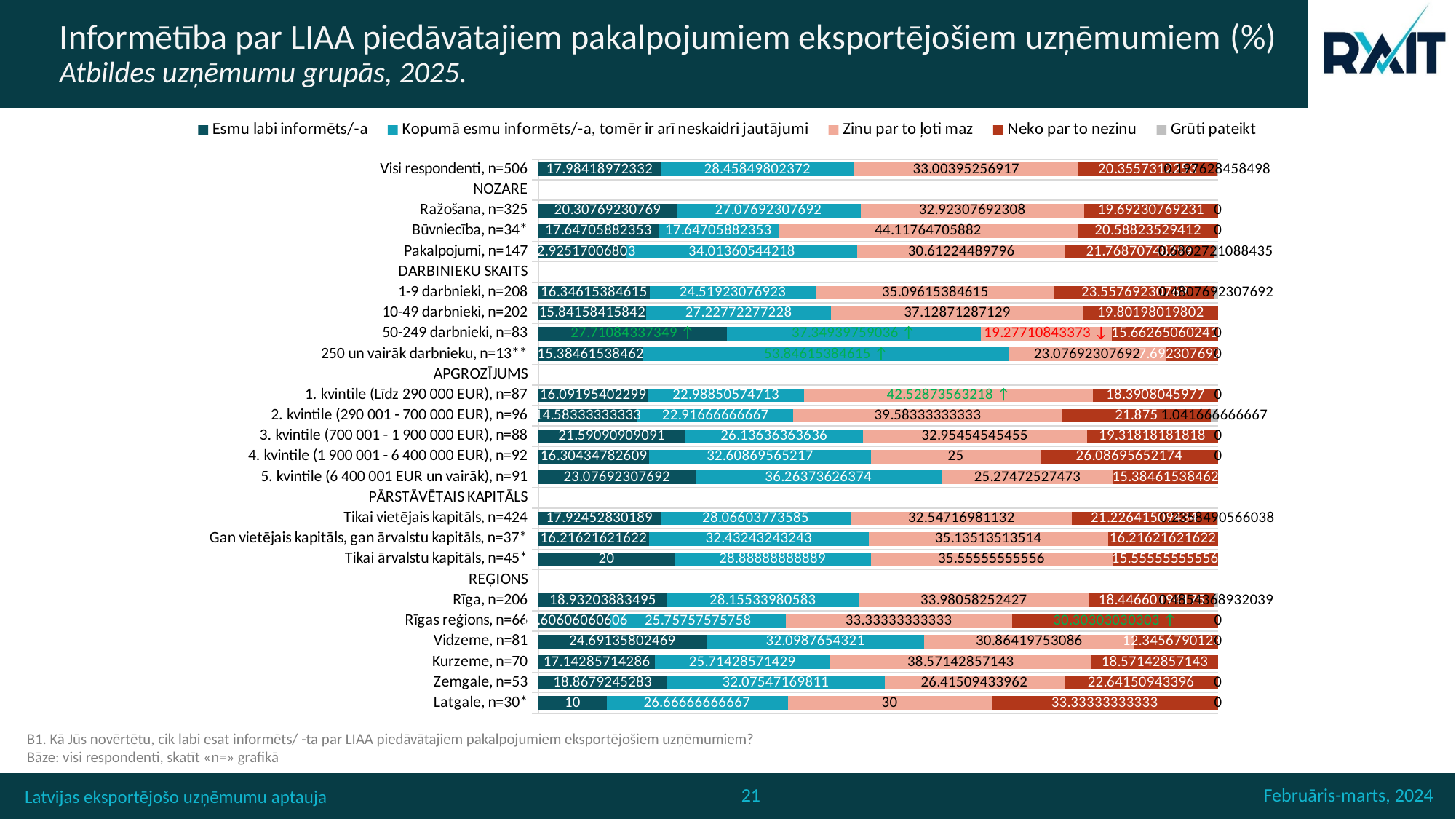
How many series does the legend list? 5 What is the value of 'Zinu par to ļoti maz' for 4. kvintile (1 900 001 - 6 400 000 EUR), n=92? 25 What is the value of 'Esmu labi informēts/-a' for Latgale, n=30*? 10 What is the value of 'Neko par to nezinu' for Latgale, n=30*? 33.33333333333 What kind of chart is shown on the slide? Stacked bar chart How many groups are listed under the REĢIONS section? 6 What is the difference between 'Zinu par to ļoti maz' and 'Esmu labi informēts/-a' for Latgale, n=30*? 20 Which group has the highest value for 'Zinu par to ļoti maz'? Būvniecība, n=34* What is the value of 'Zinu par to ļoti maz' for Būvniecība, n=34*? 44.11764705882 Which group has the lowest value for 'Esmu labi informēts/-a'? Latgale, n=30* For Latgale, n=30*, which is larger: 'Neko par to nezinu' or 'Zinu par to ļoti maz'? Neko par to nezinu What is the value of 'Kopumā esmu informēts/-a, tomēr ir arī neskaidri jautājumi' for 5. kvintile (6 400 001 EUR un vairāk), n=91? 36.26373626374